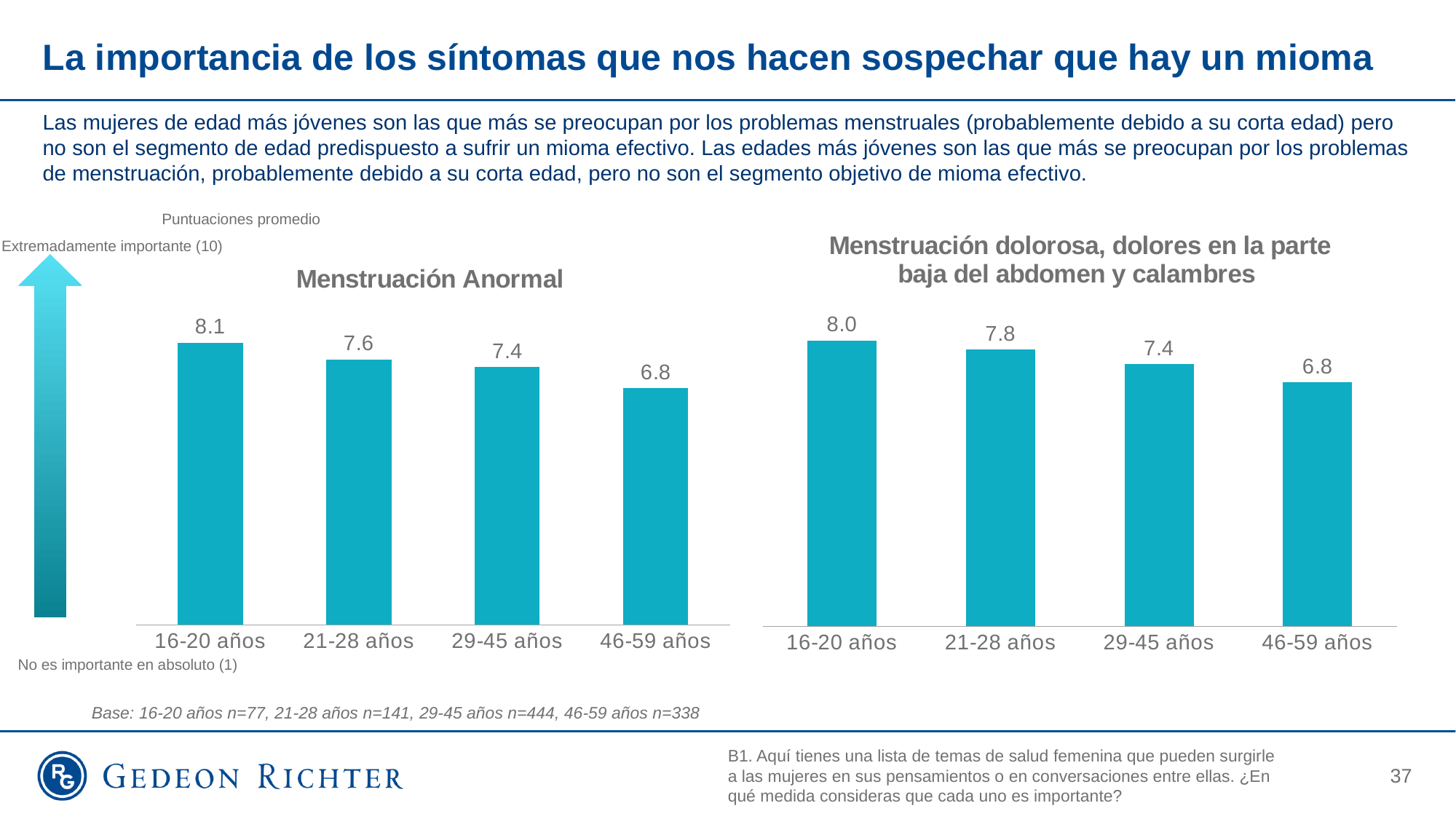
In the 'Menstruación Anormal' chart, which is larger: the value for 21-28 años or the value for 29-45 años? 21-28 años In the 'Menstruación Anormal' chart, do the values rise or fall from 16-20 años to 46-59 años? Fall In the 'Menstruación Anormal' chart, which age group has the highest value? 16-20 años In the 'Menstruación dolorosa, dolores en la parte baja del abdomen y calambres' chart, what is the difference between the values for 16-20 años and 21-28 años? 0.2 In the 'Menstruación Anormal' chart, what is the difference between the values for 16-20 años and 46-59 años? 1.3 In the 'Menstruación dolorosa, dolores en la parte baja del abdomen y calambres' chart, which age group has the lowest value? 46-59 años In the 'Menstruación dolorosa, dolores en la parte baja del abdomen y calambres' chart, what is the value for 21-28 años? 7.8 What type of chart is the 'Menstruación dolorosa, dolores en la parte baja del abdomen y calambres' chart? Bar chart In the 'Menstruación Anormal' chart, what is the value for 16-20 años? 8.1 In the 'Menstruación Anormal' chart, what is the value for 46-59 años? 6.8 How many age groups are shown in the 'Menstruación Anormal' chart? 4 In the 'Menstruación dolorosa, dolores en la parte baja del abdomen y calambres' chart, what is the value for 29-45 años? 7.4